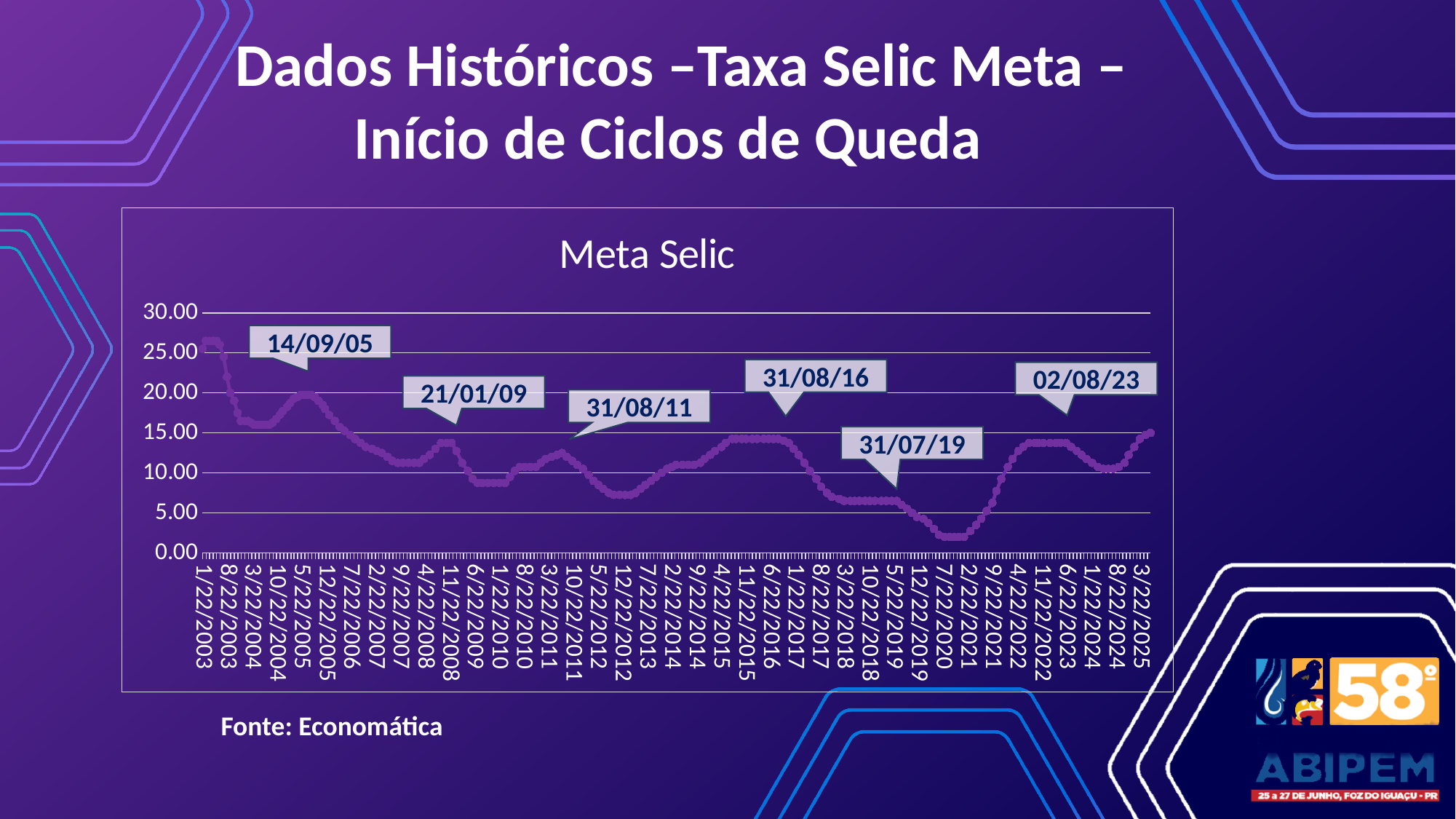
Is the value of the Meta Selic at 3/22/2025 greater or less than 10.00? greater What is the highest value shown on the y axis of the chart? 30.00 What kind of chart is shown on the slide? line chart Is the value of the Meta Selic at 12/22/2012 greater or less than 10.00? less Does the Meta Selic line rise or fall between 2/22/2021 and 11/22/2022? rise What is the title of the chart? Meta Selic Is the value of the Meta Selic at 1/22/2003 greater or less than 25.00? greater How many date callouts (annotations) are placed on the chart? 6 Does the Meta Selic line rise or fall between 1/22/2003 and 3/22/2004? fall Does the Meta Selic line reach its highest value at the start or at the end of the period shown? start